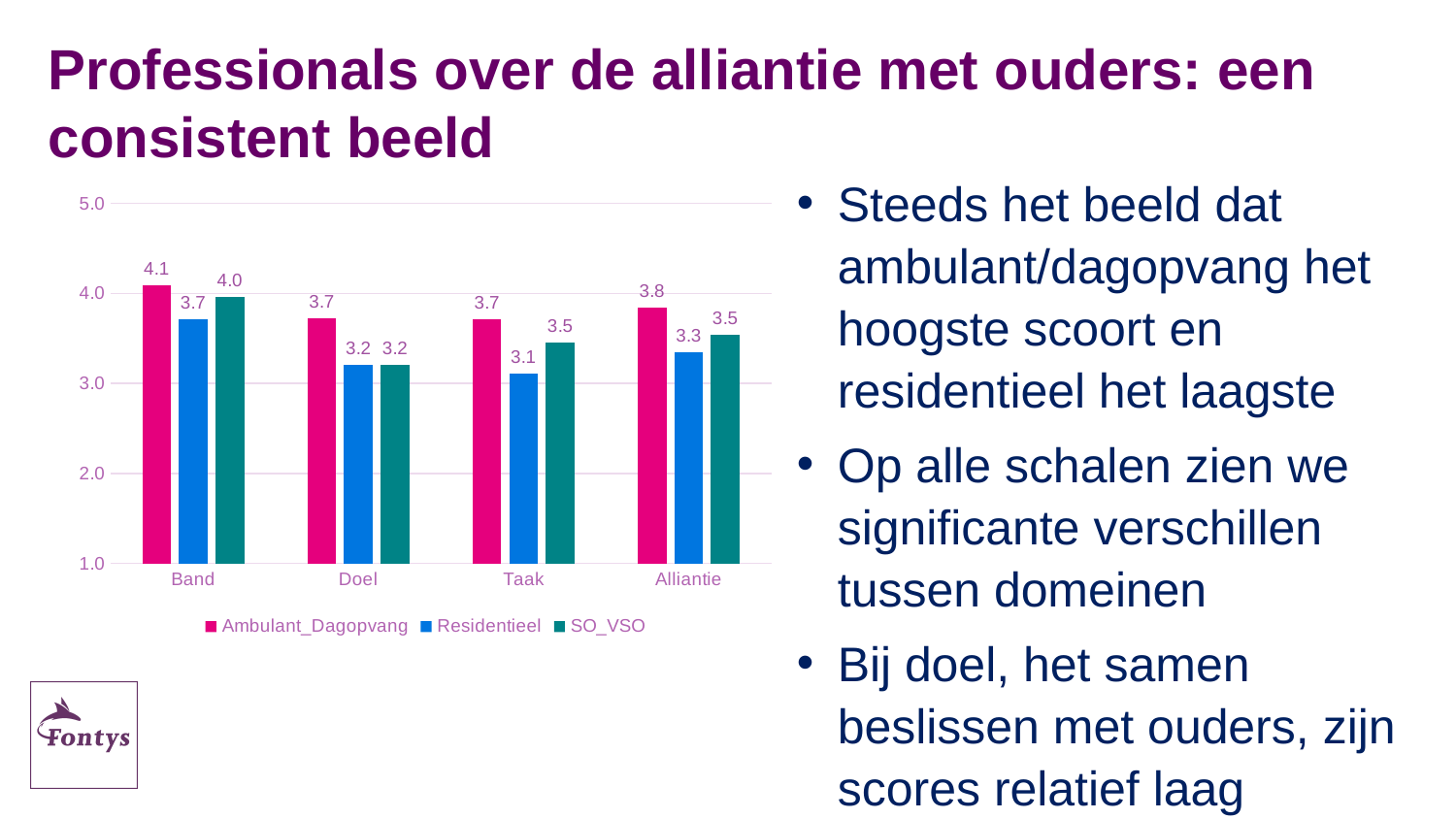
What is the difference between the Ambulant_Dagopvang and Residentieel values in the Doel category? 0.5 Which category has the lowest value for Residentieel? Taak How many categories are shown on the x axis? 4 What kind of chart is shown on the slide? Bar chart Is the value for Residentieel in the Band category greater or less than 3.0? greater What is the value for Ambulant_Dagopvang in the Band category? 4.1 How many series does the legend list? 3 Which category has the highest value for Ambulant_Dagopvang? Band What is the value for SO_VSO in the Alliantie category? 3.5 What is the value for Residentieel in the Taak category? 3.1 Which is larger in the Taak category: the SO_VSO value or the Residentieel value? SO_VSO Which series is shown in pink in the legend? Ambulant_Dagopvang